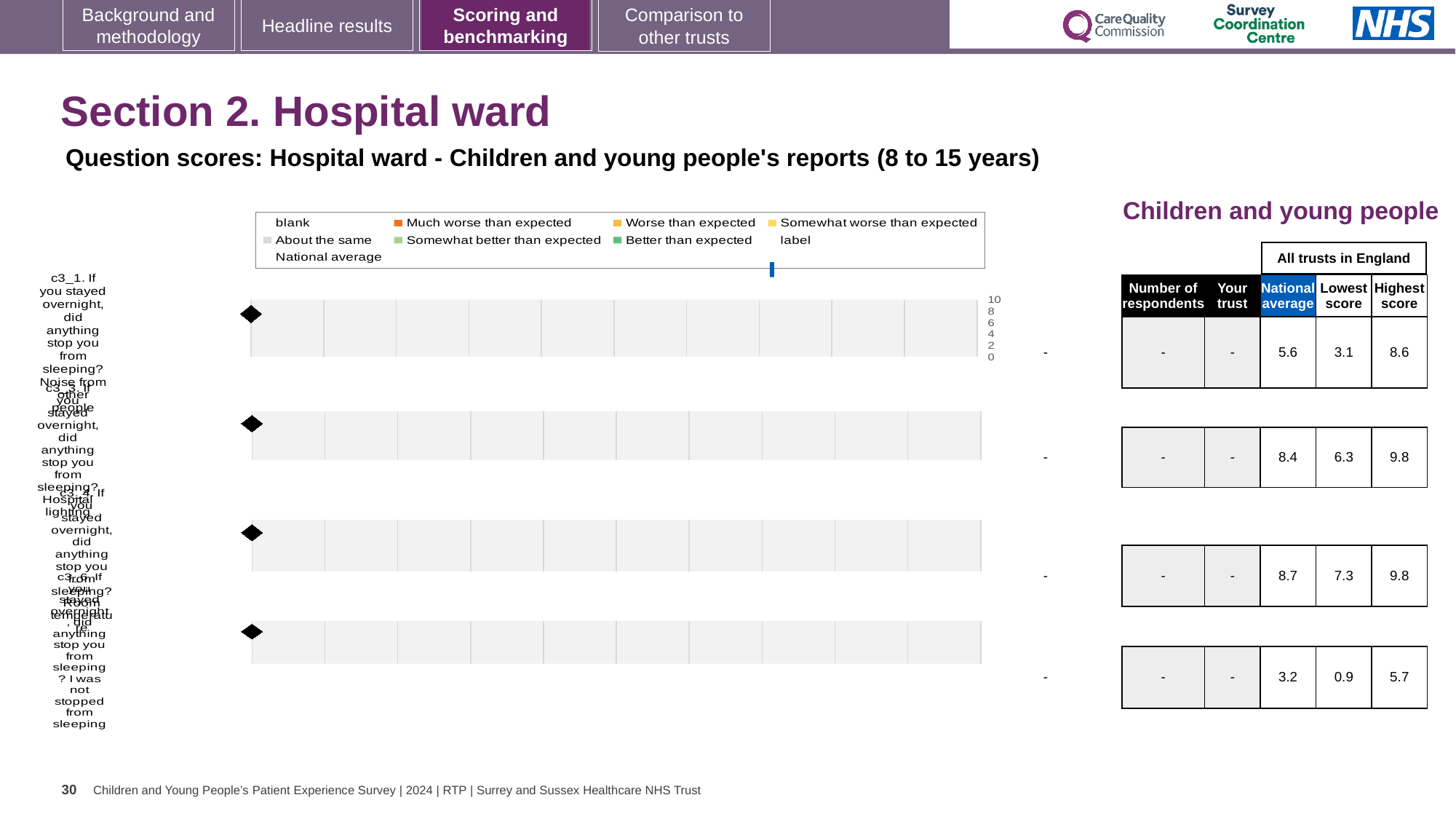
How many question rows (bars) does the chart show? 4 What kind of chart is shown on the slide? bar chart In the table next to the chart, what is the lowest score for the fourth row? 0.9 In the table next to the chart, what is the difference between the highest and lowest score for the fourth row? 4.8 What is the maximum value shown on the chart's axis? 10 In the table next to the chart, what value is shown in the 'Your trust' column for each row? - In the table next to the chart, what is the lowest score for the second row? 6.3 In the table next to the chart, what is the national average for the third row? 8.7 In the table next to the chart, what is the highest score for the first row (c3_1)? 8.6 In the table next to the chart, which row has the lowest national average? the fourth row (3.2) What colour does the legend use for 'Much worse than expected'? orange In the table next to the chart, what is the national average for the first row (c3_1, noise from other people)? 5.6